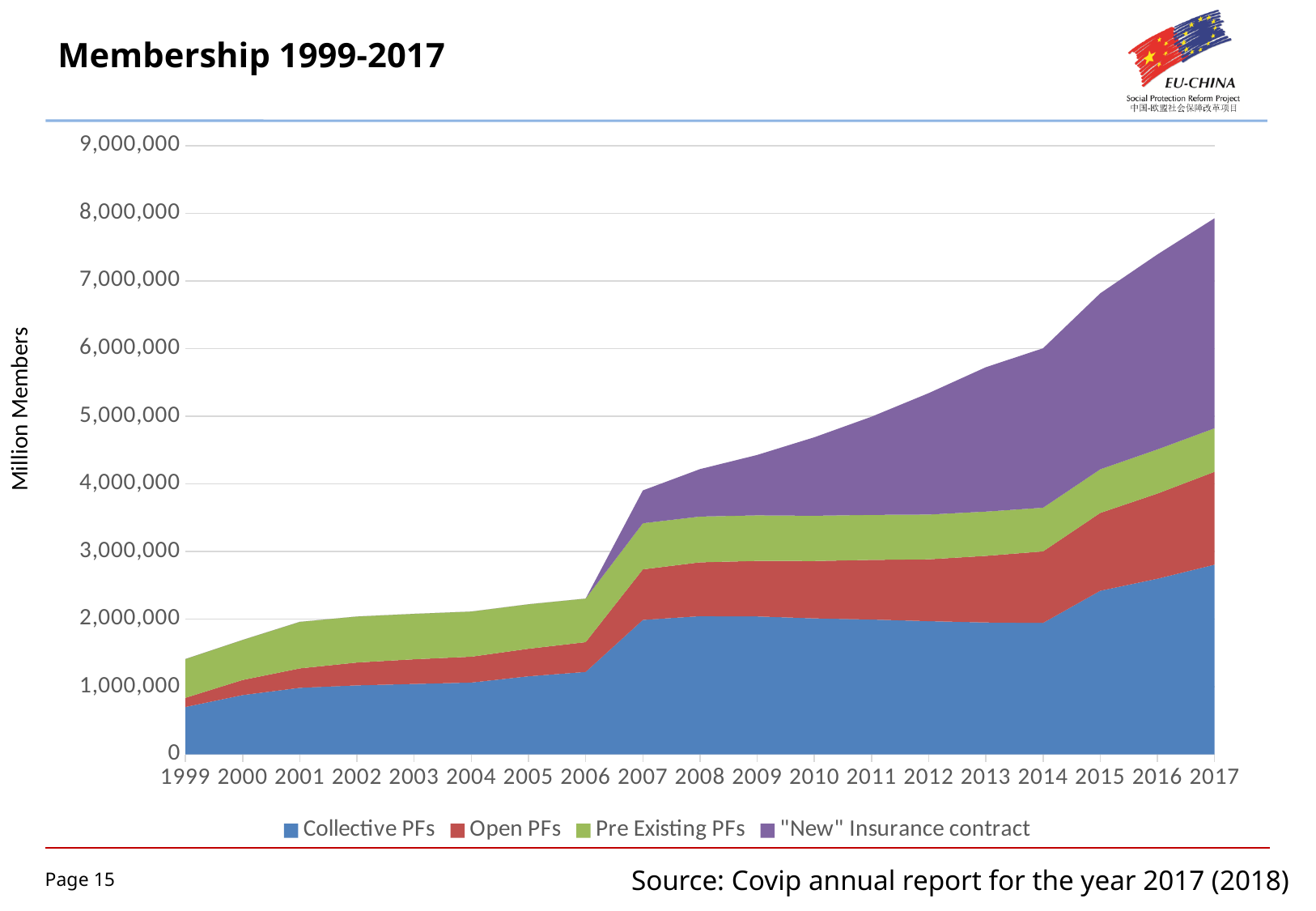
Is the total membership in 2010 greater or less than 5,000,000? less Is the total membership in 2017 greater or less than 7,000,000? greater Does total membership generally rise or fall from 1999 to 2017? Rise Is the total membership in 1999 greater or less than 1,000,000? greater What is the label on the y axis? Million Members How many series does the legend list? 4 What kind of chart is shown on the slide? Area chart In which year is the total membership lowest? 1999 In which year is the total membership highest? 2017 In 2017, which is larger: Collective PFs or Open PFs? Collective PFs How many years are shown along the x axis? 19